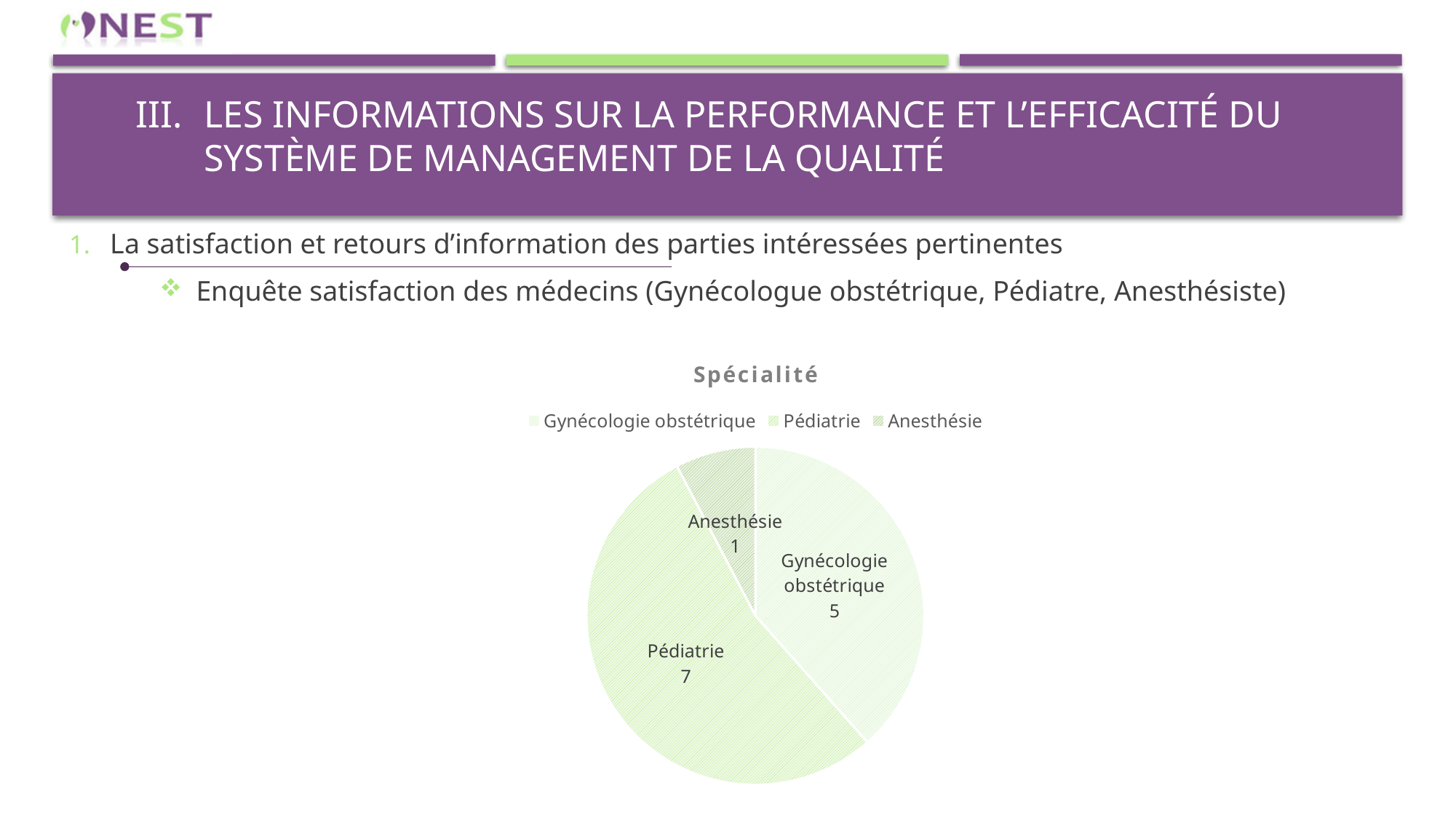
What is the value for Anesthésie? 1 What type of chart is shown on the slide? Pie chart Which specialty has the largest slice? Pédiatrie How many slices does the pie chart have? 3 How many entries does the legend list? 3 What is the difference between the values for Pédiatrie and Gynécologie obstétrique? 2 What is the total of all slices in the pie chart? 13 What is the title of the chart? Spécialité What is the value for Gynécologie obstétrique? 5 What is the value for Pédiatrie? 7 Which specialty has the smallest slice? Anesthésie Which is larger, the value for Gynécologie obstétrique or the value for Anesthésie? Gynécologie obstétrique